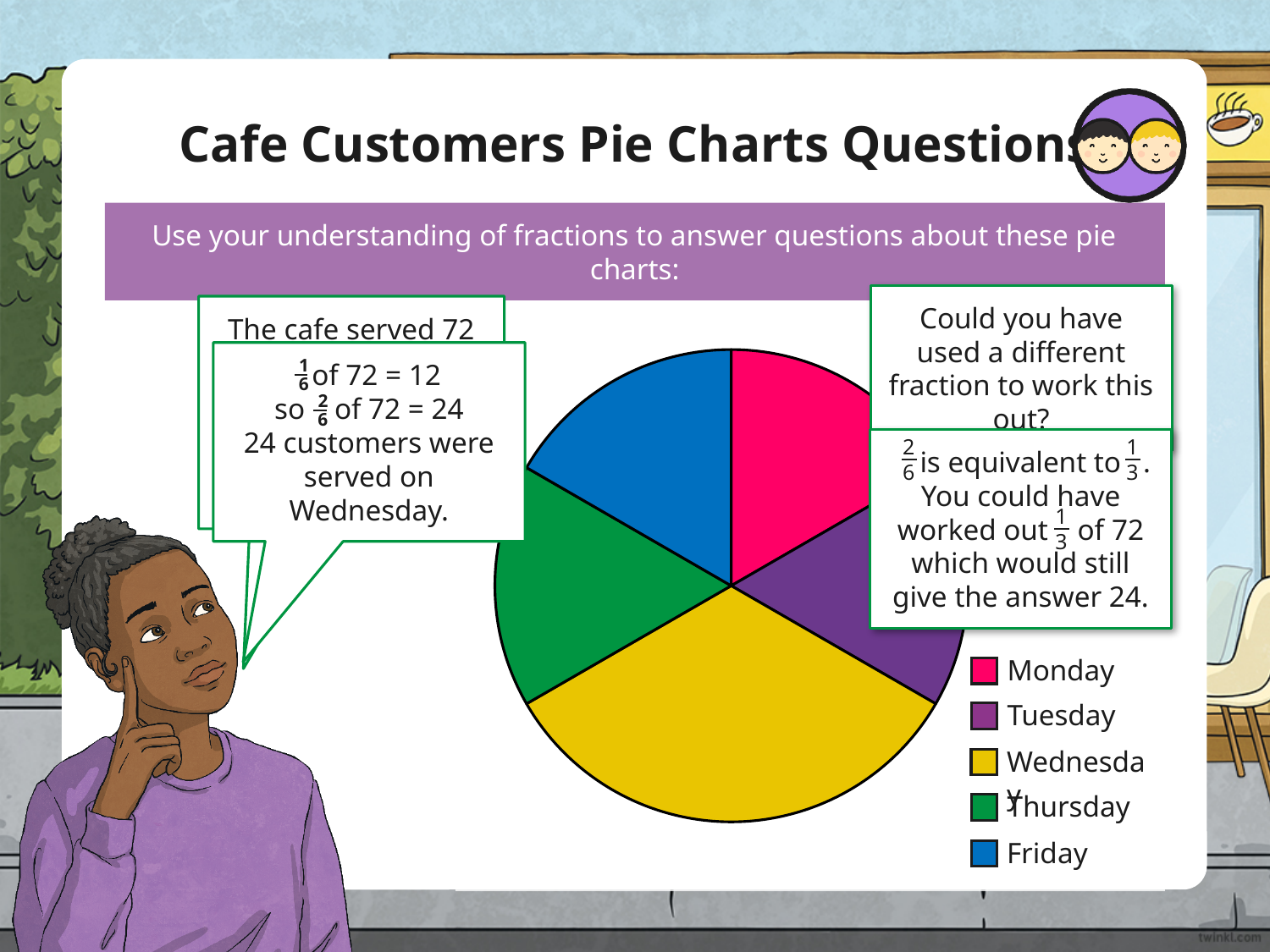
Which slice is larger, Wednesday or Friday? Wednesday According to the slide, how many customers were served on Wednesday? 24 Which day has the largest slice of the pie chart? Wednesday Which day is shown in yellow in the pie chart? Wednesday How many entries does the legend of the pie chart list? 5 Which colour represents Friday in the pie chart? blue Which slice is larger, Wednesday or Monday? Wednesday According to the slide, what fraction of the pie chart does Wednesday represent? 2/6 According to the slide, how many customers did the cafe serve in total? 72 What kind of chart is shown on the slide? pie chart How many slices does the pie chart have? 5